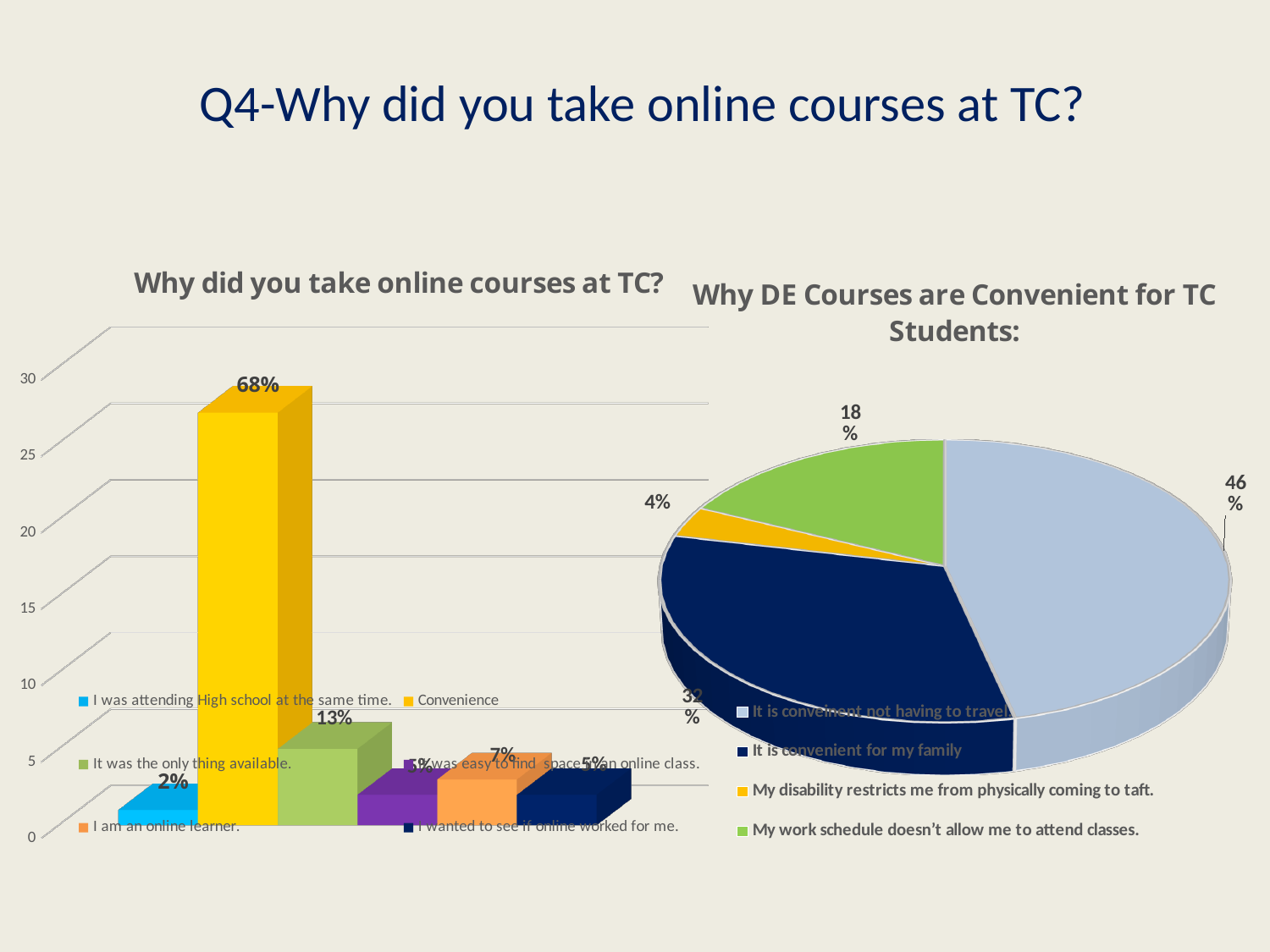
In the bar chart 'Why did you take online courses at TC?', what is the difference between the values for Convenience and 'It was the only thing available.'? 55% In the bar chart 'Why did you take online courses at TC?', what is the value for 'I am an online learner.'? 7% In the bar chart 'Why did you take online courses at TC?', which category has the highest value? Convenience In the pie chart 'Why DE Courses are Convenient for TC Students:', which slice is the largest? It is convenient not having to travel What kind of chart is the left chart titled 'Why did you take online courses at TC?'? Bar chart How many entries does the legend of the pie chart 'Why DE Courses are Convenient for TC Students:' list? 4 In the pie chart 'Why DE Courses are Convenient for TC Students:', what share is 'My work schedule doesn't allow me to attend classes.'? 18% In the bar chart 'Why did you take online courses at TC?', what is the value for 'It was the only thing available.'? 13% In the pie chart 'Why DE Courses are Convenient for TC Students:', which slice is the smallest? My disability restricts me from physically coming to taft. In the bar chart 'Why did you take online courses at TC?', what is the value for Convenience? 68% In the bar chart 'Why did you take online courses at TC?', which is larger: 'It was the only thing available.' or 'I am an online learner.'? It was the only thing available. In the bar chart 'Why did you take online courses at TC?', what is the value for 'I was attending High school at the same time.'? 2%